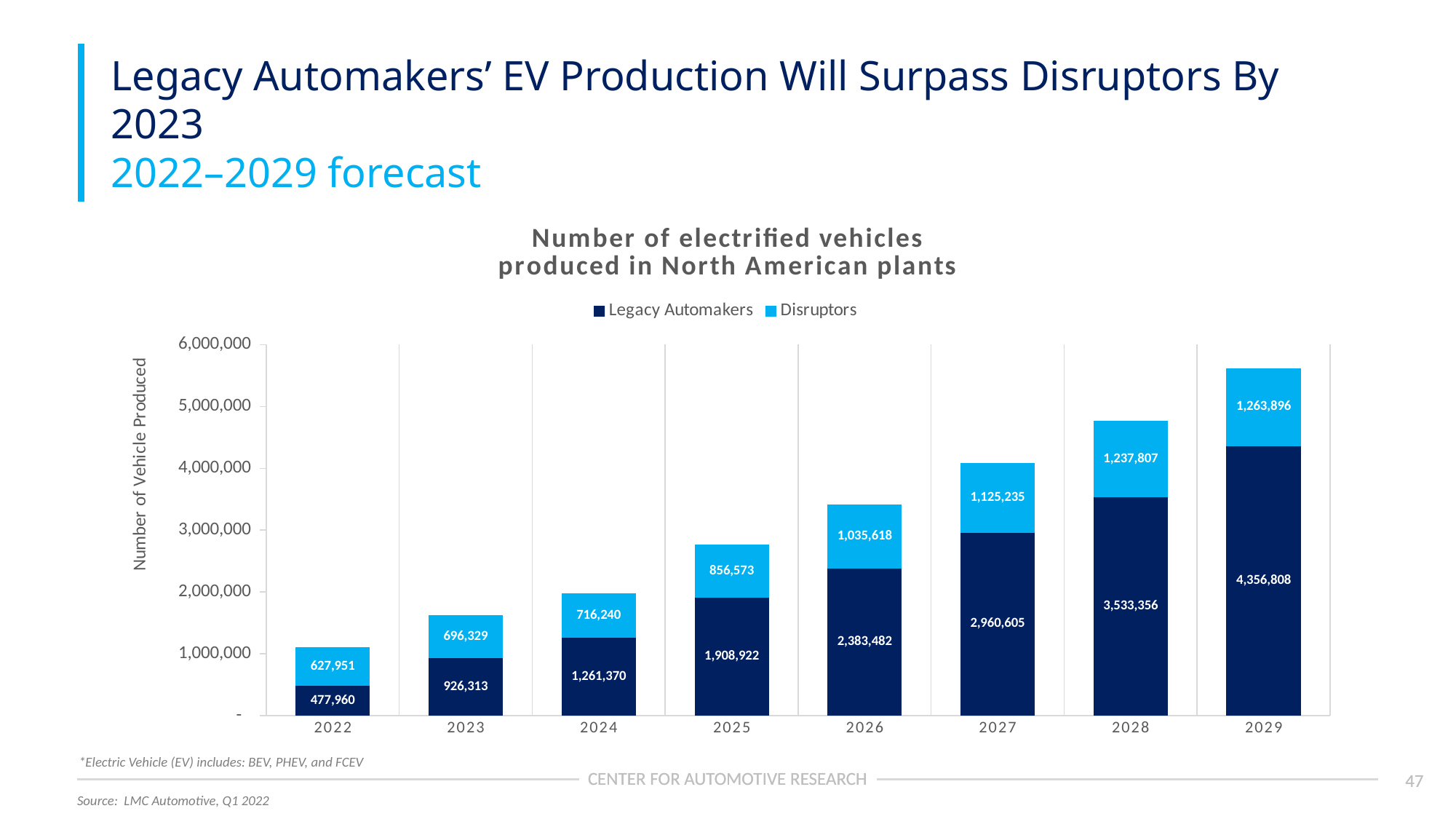
What is the total of the stacked bar for 2022? 1,105,911 How many years are shown on the x axis? 8 What is the value for Disruptors in 2027? 1,125,235 How many series does the legend list? 2 In 2022, which is larger: Legacy Automakers or Disruptors? Disruptors Which year has the highest value for Legacy Automakers? 2029 Do the Legacy Automakers values rise or fall from 2022 to 2029? Rise What is the value for Legacy Automakers in 2025? 1,908,922 Is the total stacked bar for 2028 greater or less than 4,000,000? greater What is the difference between Legacy Automakers and Disruptors in 2029? 3,092,912 Which year has the lowest value for Disruptors? 2022 What kind of chart is shown? Stacked bar chart